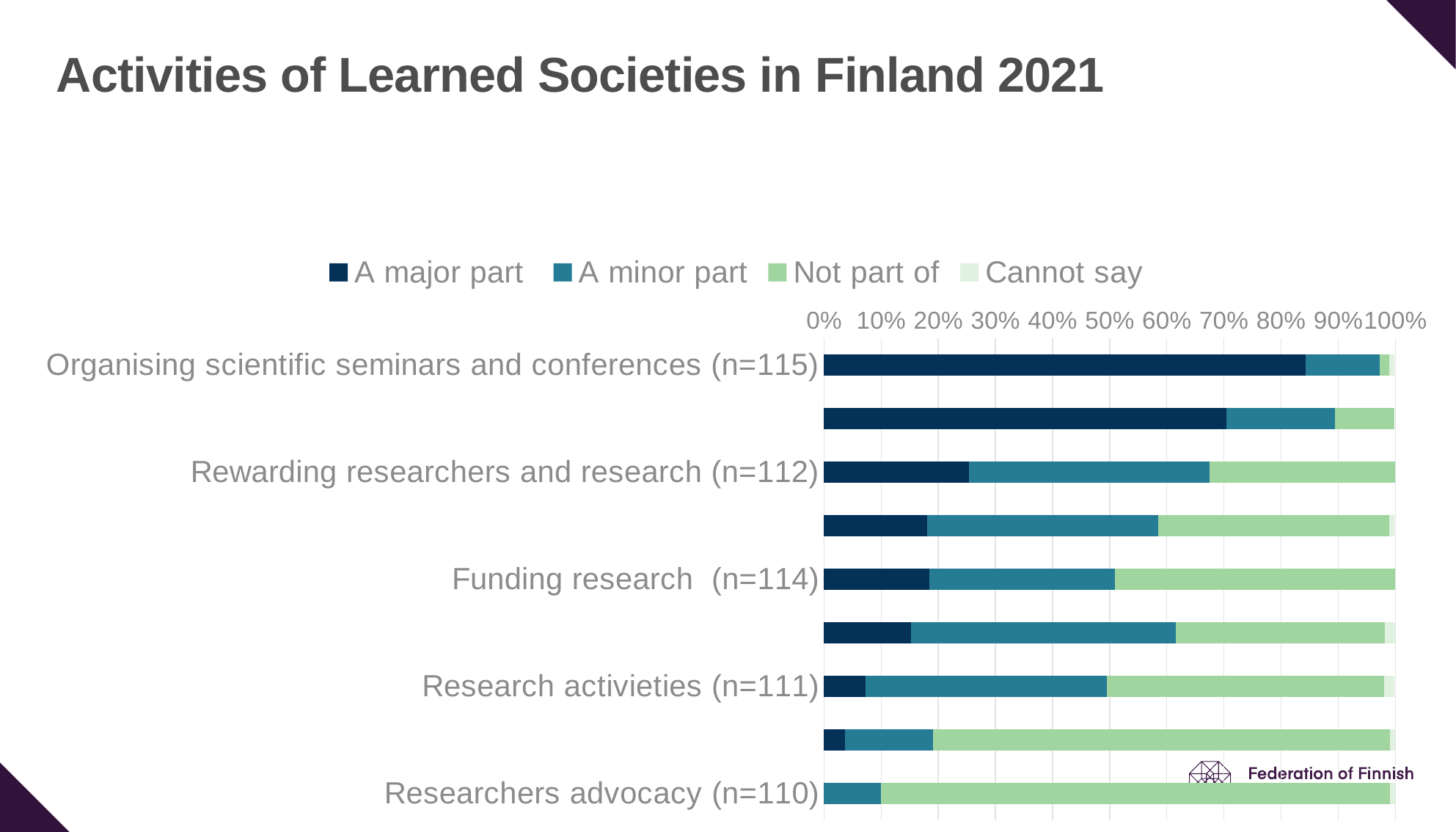
Among the labelled activities, which has the smallest 'A major part' share? Researchers advocacy (n=110) What kind of chart is shown on the slide? Stacked bar chart How many series does the legend list? 4 Is the 'A major part' share for Funding research (n=114) greater or less than 30%? less How many bars are plotted in the chart? 9 Is the 'A major part' share for Organising scientific seminars and conferences (n=115) greater or less than 80%? greater What are the four legend entries of the chart? A major part, A minor part, Not part of, Cannot say Which has a larger 'Not part of' share: Research activieties (n=111) or Rewarding researchers and research (n=112)? Research activieties (n=111) Is the 'Not part of' share for Researchers advocacy (n=110) greater or less than 80%? greater Which has a larger 'A major part' share: Organising scientific seminars and conferences (n=115) or Rewarding researchers and research (n=112)? Organising scientific seminars and conferences (n=115) Among the labelled activities, which has the largest 'A major part' share? Organising scientific seminars and conferences (n=115)